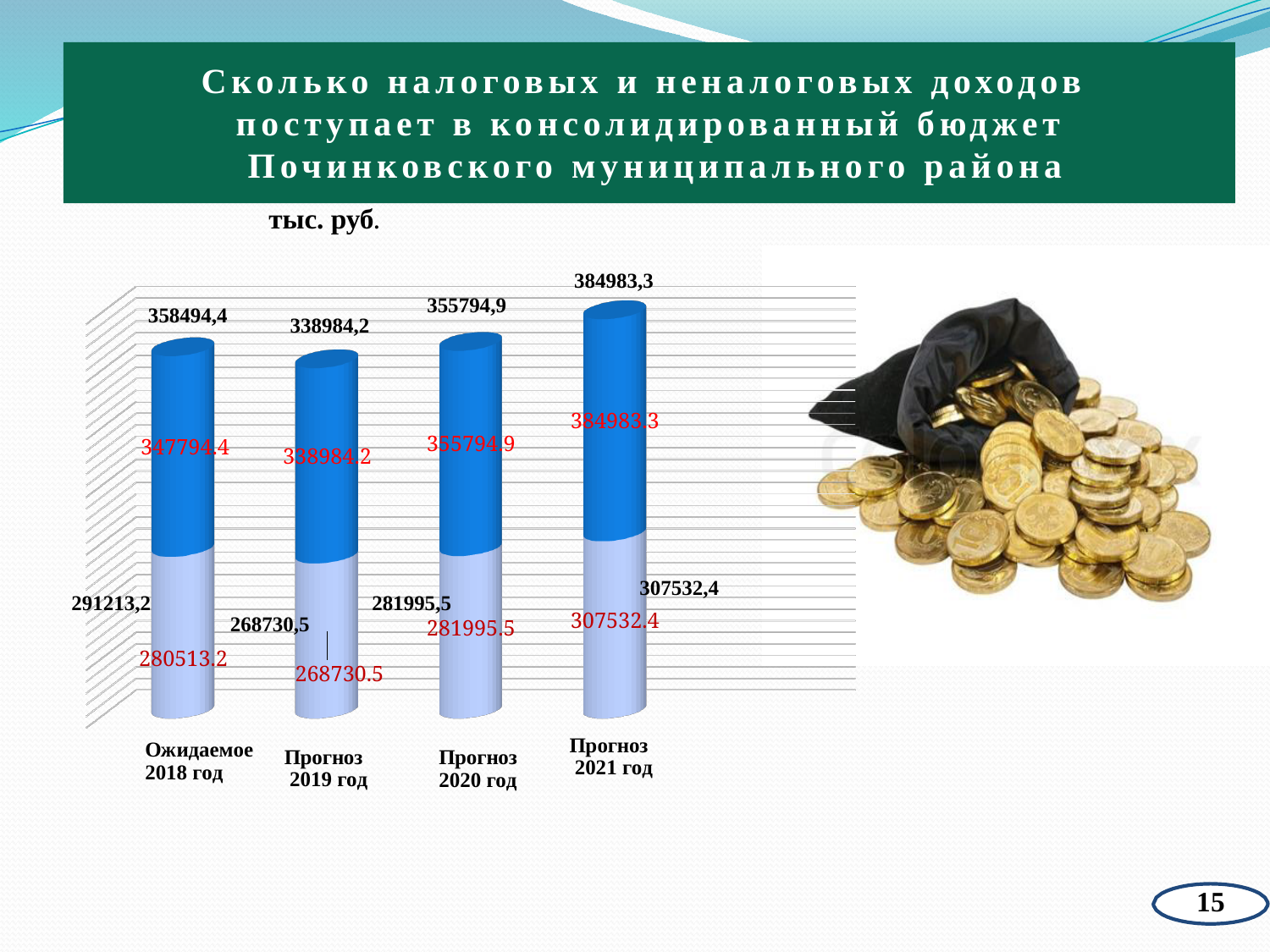
What is the value labelled on the lower light-blue segment of the bar for Прогноз 2020 год? 281995,5 Which category has the lowest value on the lower light-blue segment? Прогноз 2019 год Which category has the highest value on the upper blue segment? Прогноз 2021 год Which has the larger upper blue segment value: Прогноз 2019 год or Прогноз 2020 год? Прогноз 2020 год What kind of chart is shown on the slide? Bar chart What unit is stated above the chart? тыс. руб. What is the value labelled on the upper blue segment of the bar for Прогноз 2019 год? 338984,2 How many categories (years) are shown along the x axis of the chart? 4 What is the value labelled on the upper blue segment of the bar for Прогноз 2021 год? 384983,3 What is the difference between the lower light-blue segment values for Прогноз 2021 год and Прогноз 2020 год? 25536,9 What is the value labelled on the lower light-blue segment of the bar for Прогноз 2021 год? 307532,4 What is the difference between the upper blue segment values for Прогноз 2021 год and Прогноз 2020 год? 29188,4